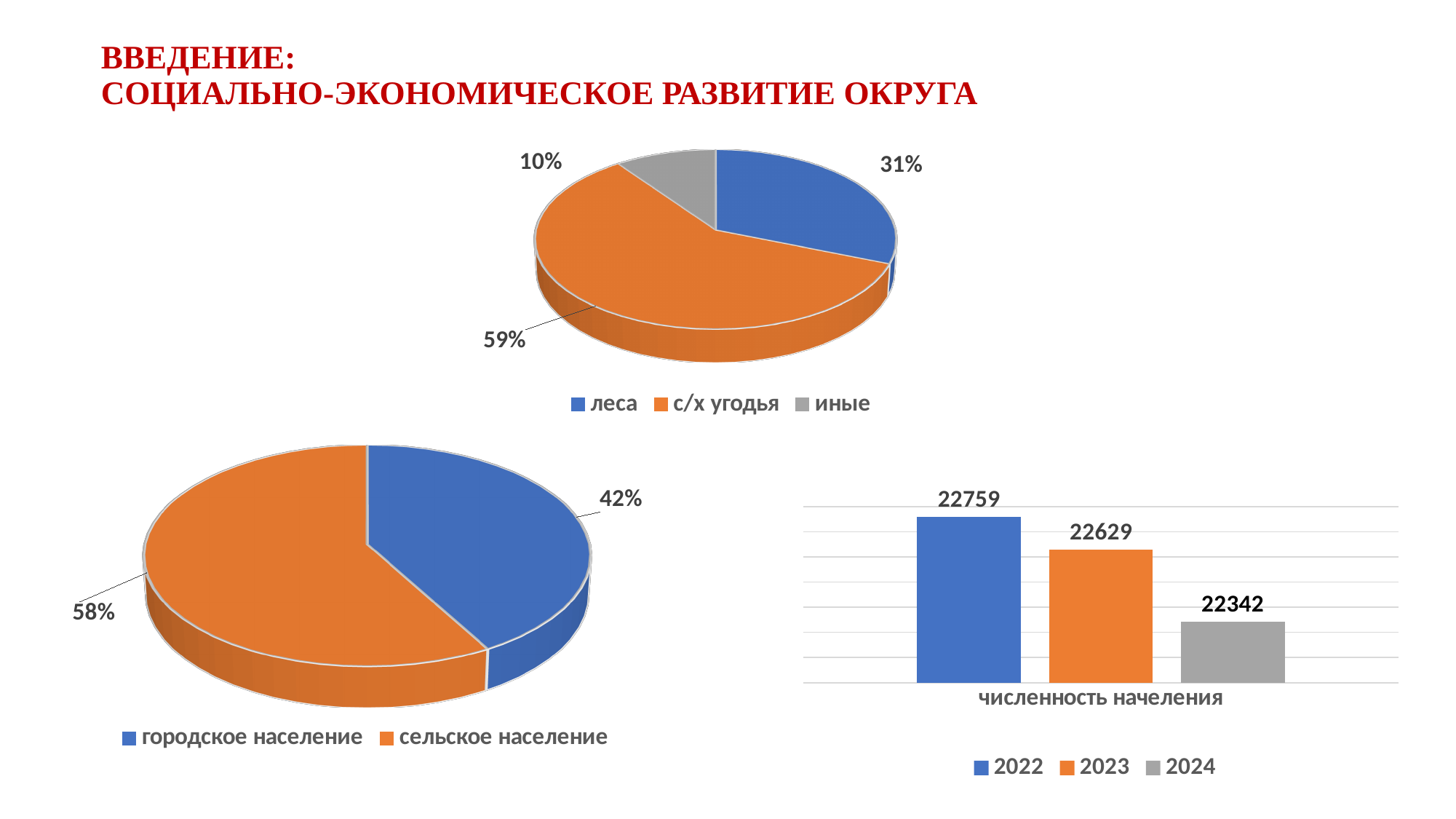
In the bottom-right bar chart, what is the value for 2023? 22629 In the top pie chart, how many categories does the legend list? 3 In the top pie chart, what share is labelled for с/х угодья? 59% In the top pie chart, which category has the smallest slice? иные What kind of chart is the bottom-right chart (численность начеления)? bar chart In the bottom-right bar chart, which year has the highest value? 2022 In the bottom-left pie chart, what share is labelled for сельское население? 58% In the top pie chart, what is the difference between the shares of с/х угодья and леса? 28% In the bottom-left pie chart, which is larger, городское население or сельское население? сельское население In the bottom-right bar chart, what is the difference between the values for 2022 and 2024? 417 In the bottom-right bar chart, do the values rise or fall from 2022 to 2024? fall In the top pie chart, what share is labelled for леса? 31%